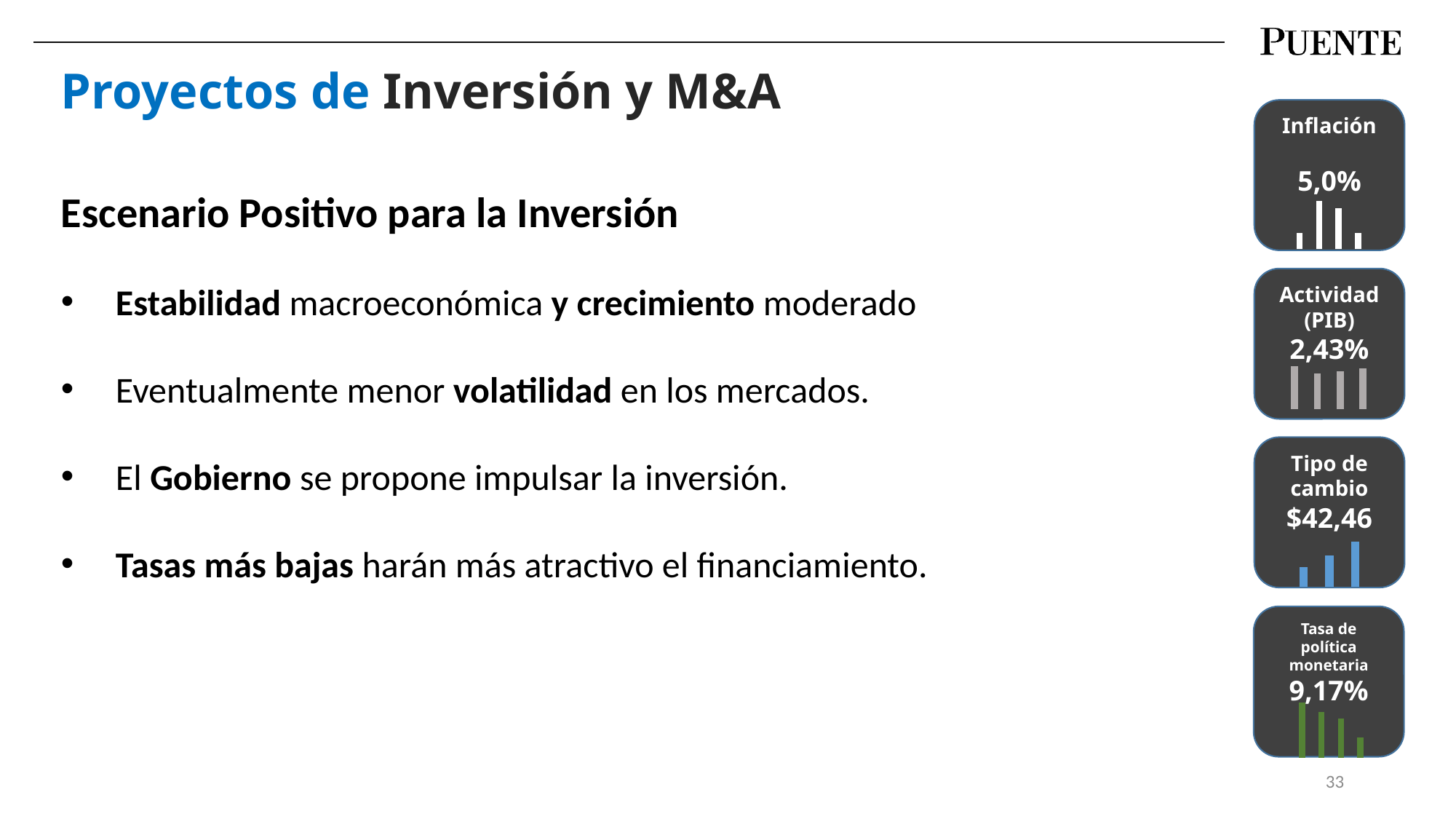
What value is shown in the Tipo de cambio tile? $42,46 What kind of chart is the small graphic inside each indicator tile on the right? Bar chart What colour are the bars in the Tasa de política monetaria tile? Green What value is shown in the Actividad (PIB) tile? 2,43% In the Tasa de política monetaria tile, do the bars rise or fall from left to right? Fall What value is shown in the Inflación tile? 5,0% How many indicator tiles with mini bar charts are shown on the right side of the slide? 4 What colour are the bars in the Tipo de cambio tile? Blue What value is shown in the Tasa de política monetaria tile? 9,17% In the Tipo de cambio tile, do the bars rise or fall from left to right? Rise How many bars are in the mini chart of the Actividad (PIB) tile? 4